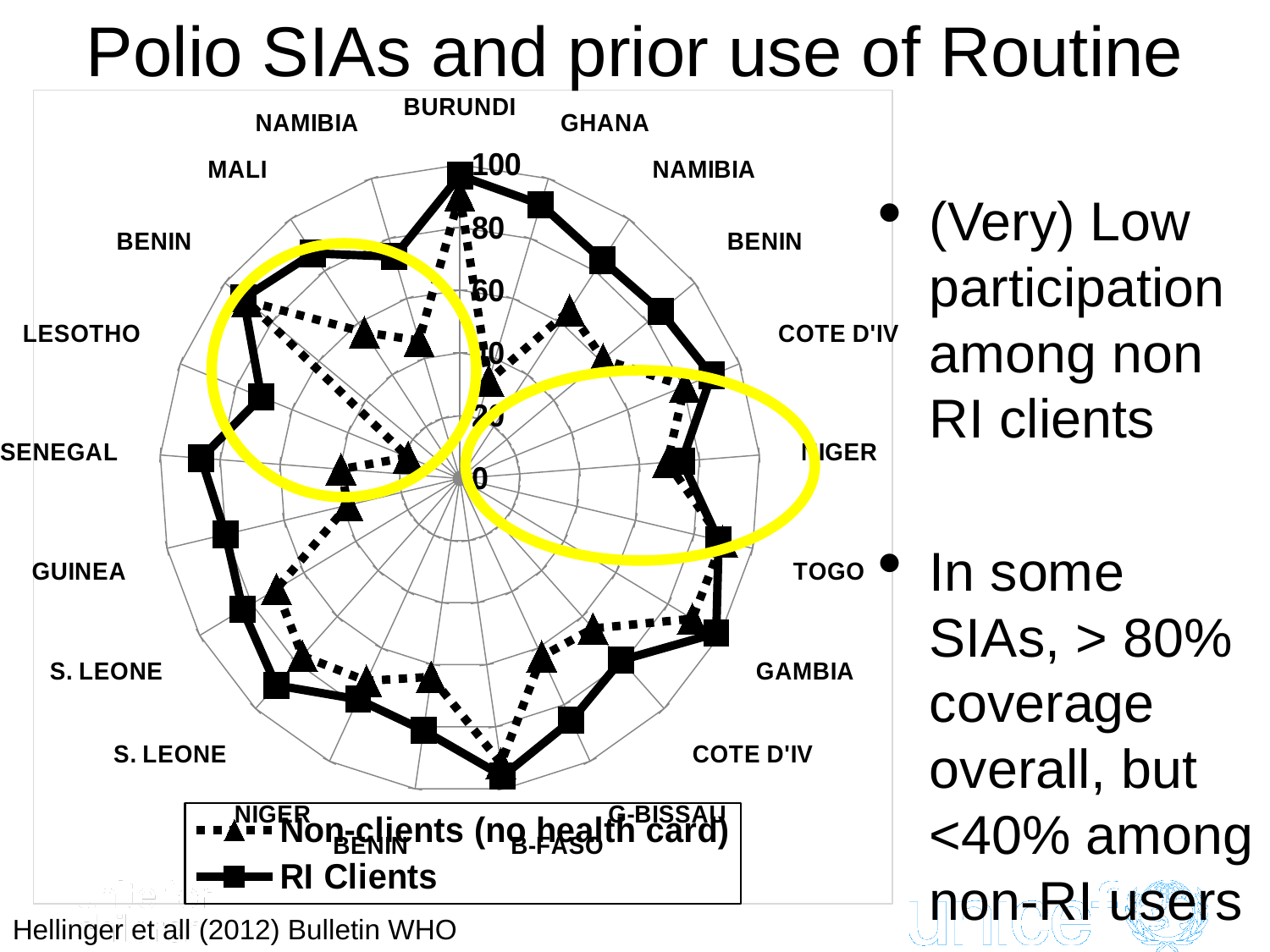
How many series does the chart's legend list? 2 Is the Non-clients (no health card) value for LESOTHO greater or less than 40? less Is the RI Clients value for SENEGAL greater or less than 80? greater What is the title of the slide containing the chart? Polio SIAs and prior use of Routine For LESOTHO, which series has the larger value, RI Clients or Non-clients (no health card)? RI Clients What kind of chart is shown on the slide? Radar chart Which category has the lowest Non-clients (no health card) value? LESOTHO For GHANA, which series has the larger value, RI Clients or Non-clients (no health card)? RI Clients Is the RI Clients value for LESOTHO greater or less than 60? greater What are the two series named in the legend? Non-clients (no health card) and RI Clients